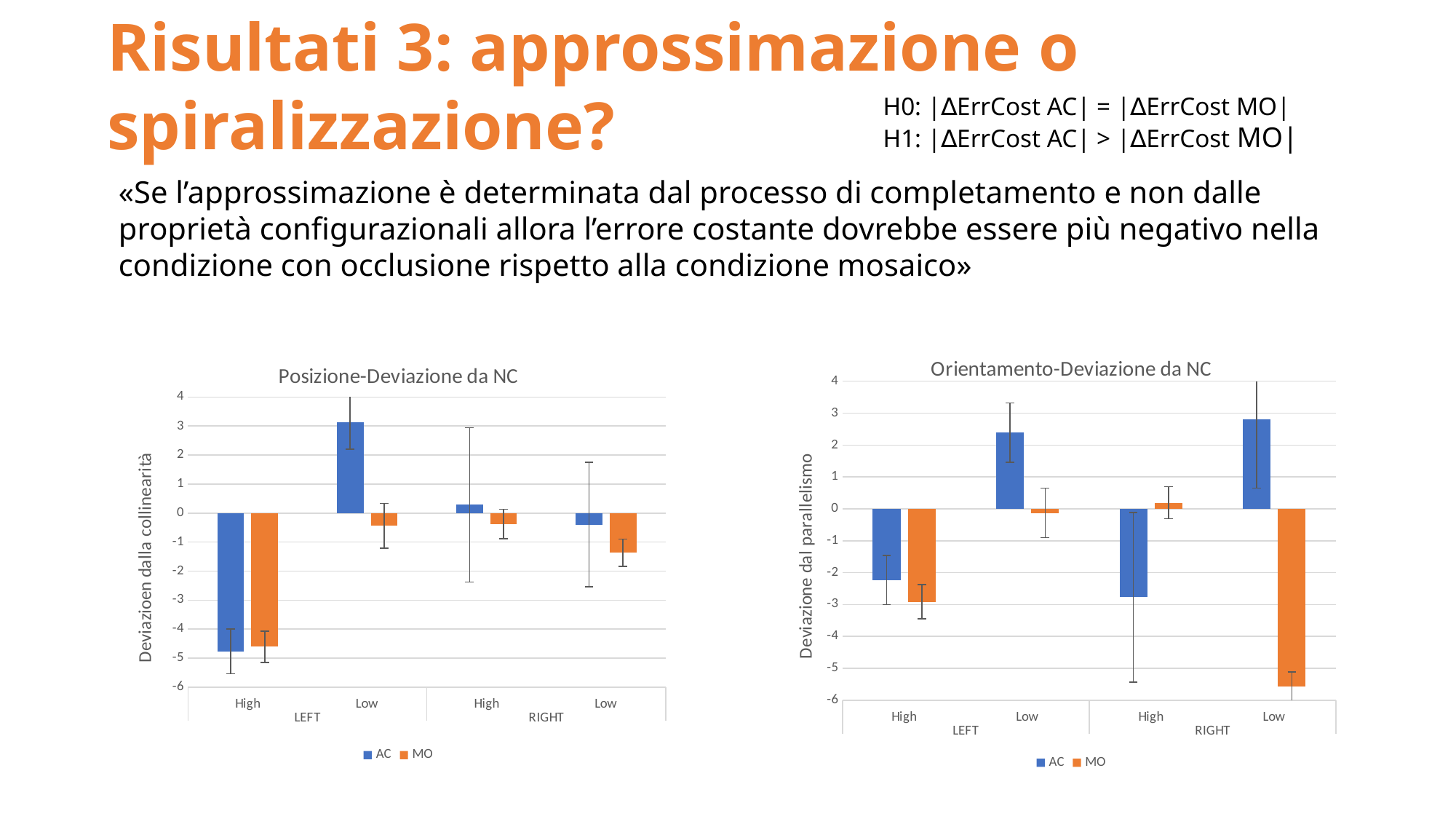
In the 'Orientamento-Deviazione da NC' chart, is the MO value for RIGHT Low greater or less than -5? less In the 'Posizione-Deviazione da NC' chart, is the AC value for LEFT Low greater or less than 2? greater In the 'Posizione-Deviazione da NC' chart, which bar has the highest value? AC at LEFT Low In the 'Posizione-Deviazione da NC' chart, is the AC value for LEFT High greater or less than -4? less What kind of chart is the 'Posizione-Deviazione da NC' chart on the left? bar chart What are the two legend entries in the 'Posizione-Deviazione da NC' chart? AC and MO In the 'Orientamento-Deviazione da NC' chart, which bar has the lowest value? MO at RIGHT Low In the 'Orientamento-Deviazione da NC' chart, how many categories are shown on the x axis? 4 In the 'Orientamento-Deviazione da NC' chart, which is lower: the MO value for LEFT High or the MO value for RIGHT Low? MO for RIGHT Low In the 'Posizione-Deviazione da NC' chart, how many series does the legend list? 2 What is the y-axis title of the 'Orientamento-Deviazione da NC' chart? Deviazione dal parallelismo